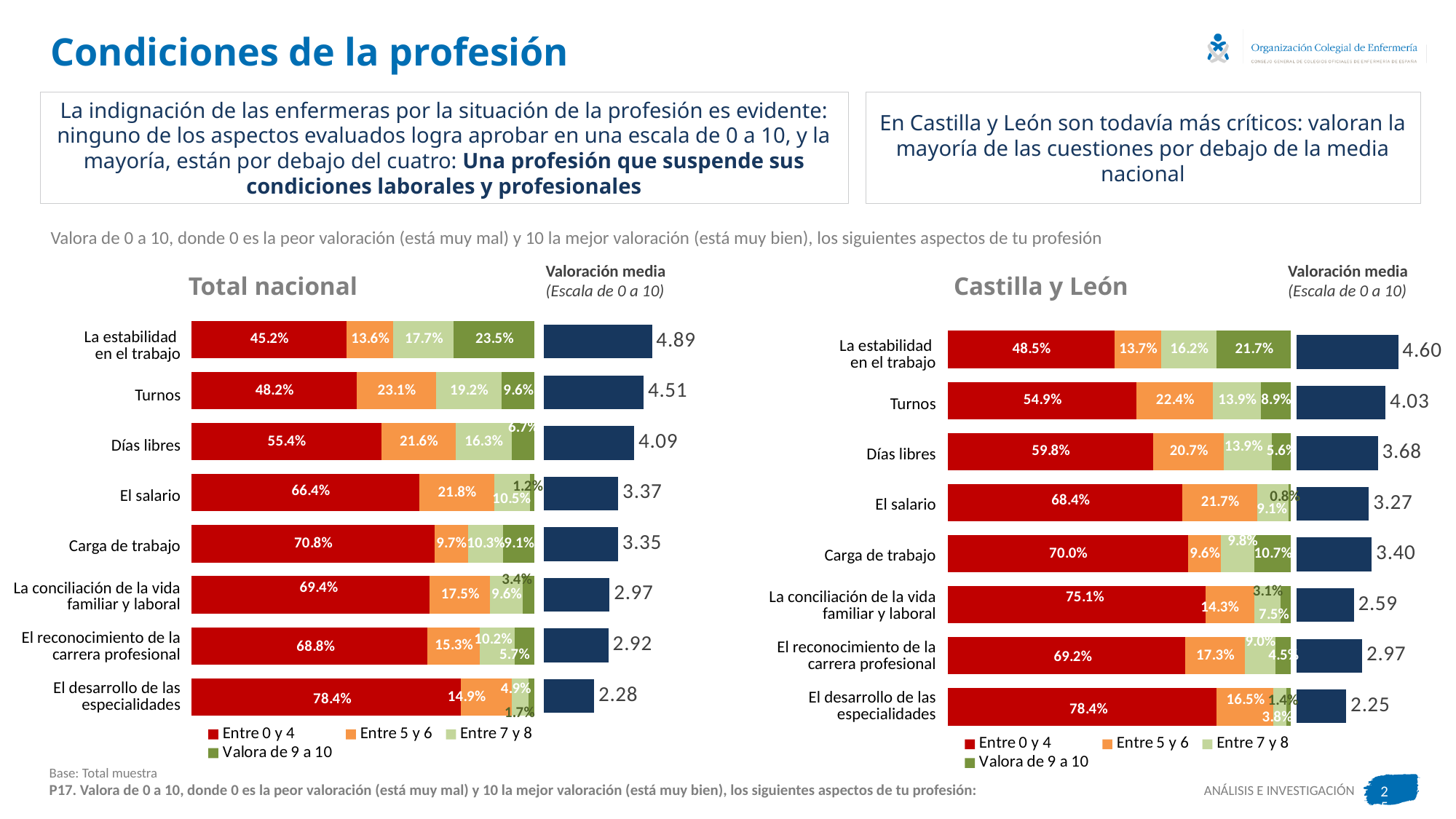
How many series does the legend of the Castilla y León chart list? 4 In the Castilla y León chart, what percentage of 'Valora de 9 a 10' is shown for 'Turnos'? 8.9% In the Castilla y León chart, what is the 'Valoración media' for 'La conciliación de la vida familiar y laboral'? 2.59 What is the difference between the 'Valoración media' for 'Turnos' in the Total nacional chart and in the Castilla y León chart? 0.48 In the Castilla y León chart, what is the total of the 'Entre 0 y 4' and 'Entre 5 y 6' percentages for 'El salario'? 90.1% How many aspects (categories) are listed in the Total nacional chart? 8 In the Total nacional chart, which aspect has the lowest 'Valoración media'? El desarrollo de las especialidades In the Total nacional chart, what is the 'Valoración media' for 'La estabilidad en el trabajo'? 4.89 Which is larger: the 'Entre 0 y 4' percentage for 'Días libres' in the Total nacional chart or in the Castilla y León chart? Castilla y León In the Total nacional chart, what percentage of 'Entre 0 y 4' is shown for 'El desarrollo de las especialidades'? 78.4% In the Castilla y León chart, which aspect has the highest 'Valoración media'? La estabilidad en el trabajo What type of chart is the Total nacional chart? Stacked bar chart